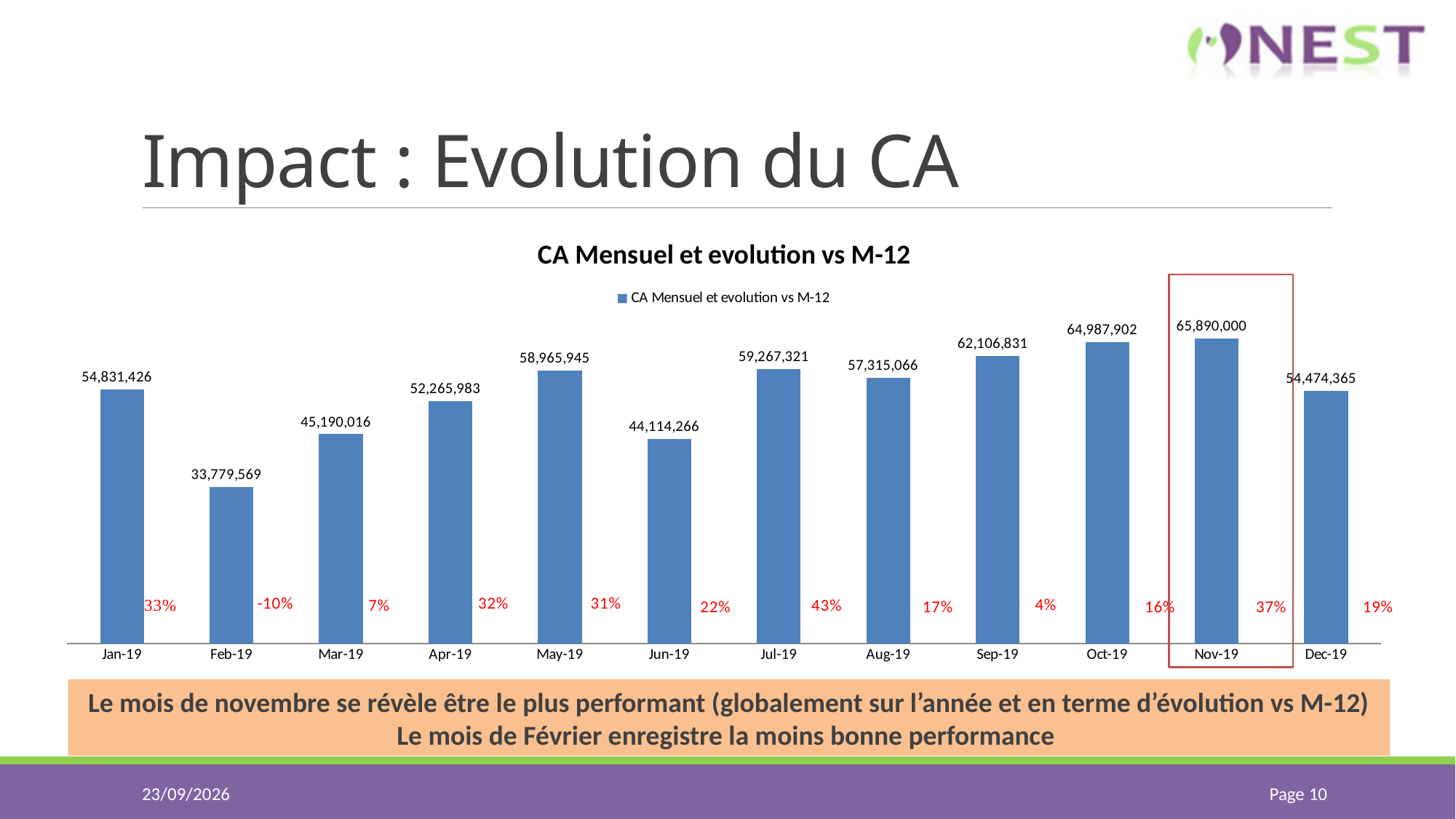
What is the difference between the CA Mensuel values for Nov-19 and Feb-19? 32,110,431 What evolution vs M-12 percentage is shown for Jul-19? 43% Which month has the lowest CA Mensuel value? Feb-19 Which is larger, the CA Mensuel value for Oct-19 or for Nov-19? Nov-19 What evolution vs M-12 percentage is shown for Feb-19? -10% What kind of chart is shown on the slide? Bar chart What is the CA Mensuel value for Feb-19? 33,779,569 How many months are shown on the x axis of the chart? 12 What is the CA Mensuel value for Nov-19? 65,890,000 What is the CA Mensuel value for Jul-19? 59,267,321 Which month has the highest CA Mensuel value? Nov-19 What is the title of the chart? CA Mensuel et evolution vs M-12